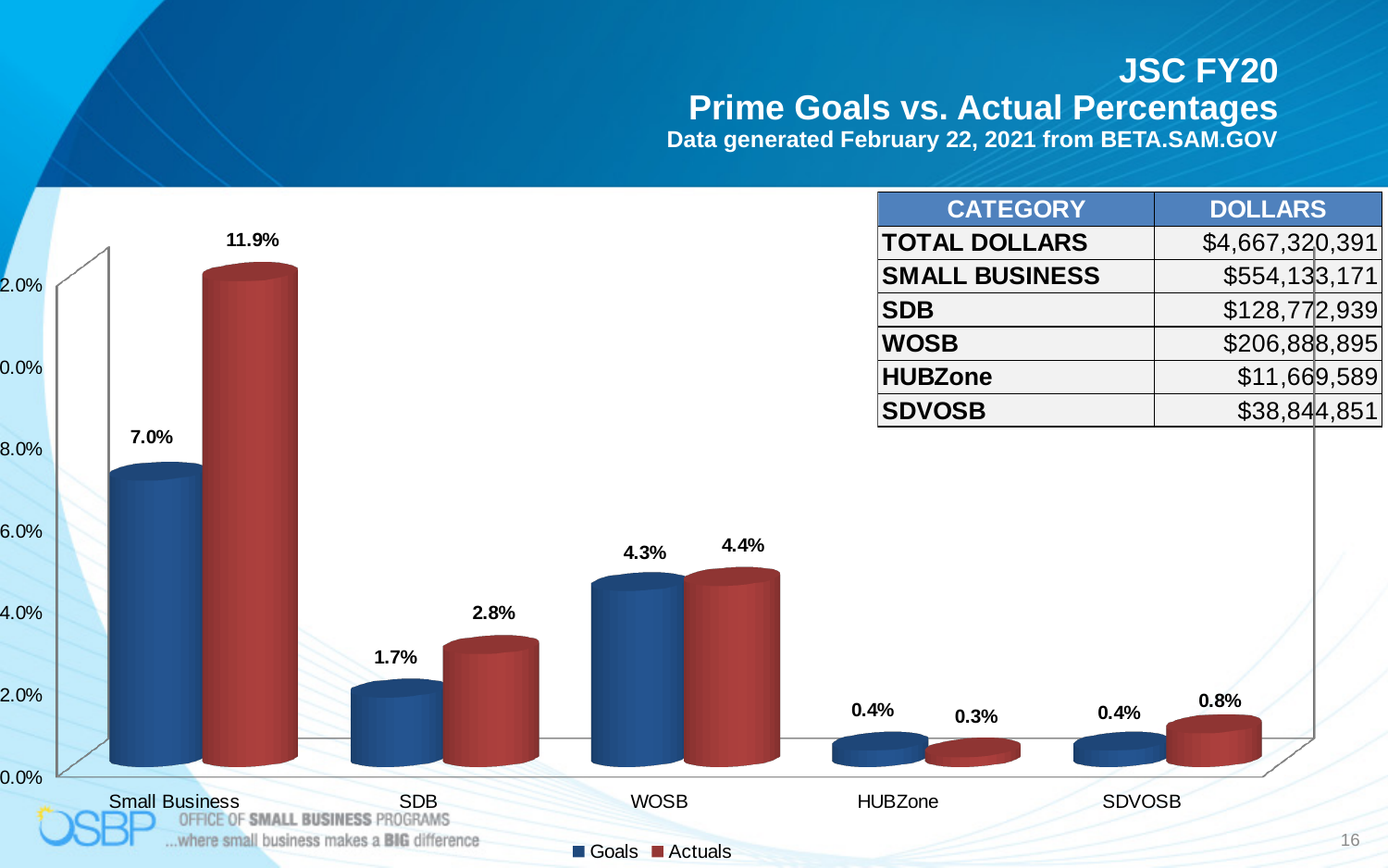
What is the Actuals value for SDVOSB? 0.8% How many categories are shown on the x axis of the chart? 5 What is the difference between the Actuals and Goals values for Small Business? 4.9% What is the Goals value for WOSB? 4.3% Which category has the highest Actuals value? Small Business What is the Goals value for SDB? 1.7% What kind of chart is shown on the slide? Bar chart How many series does the chart legend list? 2 What are the two series named in the chart legend? Goals and Actuals Which is larger for SDB, the Goals value or the Actuals value? Actuals What is the Actuals value for Small Business? 11.9% Which category has the lowest Actuals value? HUBZone